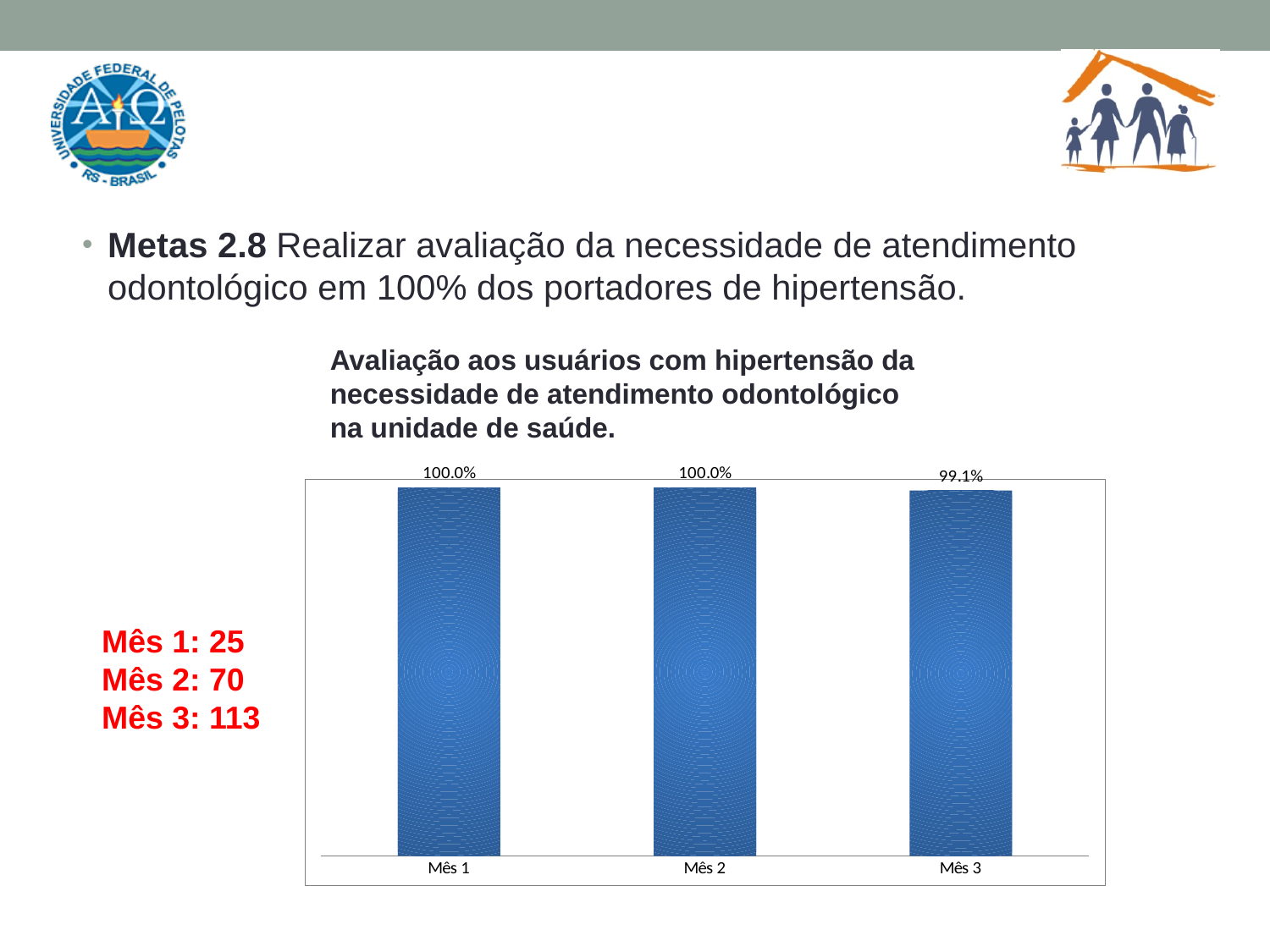
How many months are shown on the chart? 3 Do the values for Mês 1 and Mês 2 differ? No, both are 100.0% What is the difference between the values for Mês 1 and Mês 3? 0.9% What is the value for Mês 3? 99.1% What colour are the bars in the chart? Blue What is the title of the chart? Avaliação aos usuários com hipertensão da necessidade de atendimento odontológico na unidade de saúde. What is the value for Mês 1? 100.0% Do the values rise or fall from Mês 2 to Mês 3? Fall What kind of chart is shown on the slide? Bar chart Which is larger, the value for Mês 2 or the value for Mês 3? Mês 2 What is the value for Mês 2? 100.0% Which month has the lowest value? Mês 3